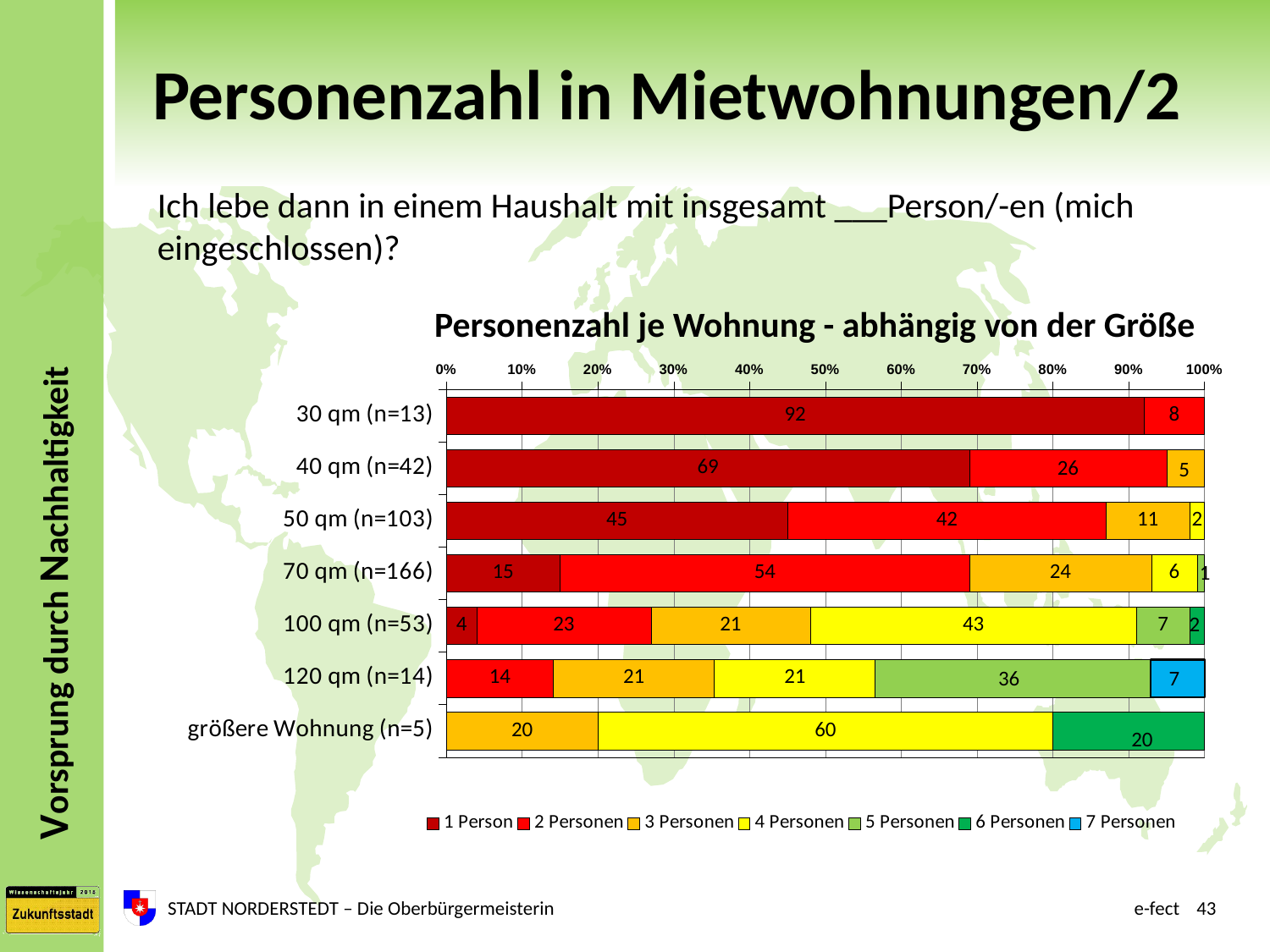
What is the title of the chart? Personenzahl je Wohnung - abhängig von der Größe What is the value for 4 Personen in the größere Wohnung (n=5) category? 60 How many series does the legend list? 7 What is the difference between the 1 Person value and the 2 Personen value in the 40 qm (n=42) category? 43 What is the value for 5 Personen in the 120 qm (n=14) category? 36 How many apartment-size categories are shown on the chart? 7 What type of chart is shown on the slide? stacked bar chart Which category has the highest value for 1 Person? 30 qm (n=13) What is the value for 1 Person in the 30 qm (n=13) category? 92 Which category has the highest value for 4 Personen? größere Wohnung (n=5) What is the value for 2 Personen in the 70 qm (n=166) category? 54 In the 100 qm (n=53) category, which is larger: the value for 2 Personen or the value for 4 Personen? 4 Personen